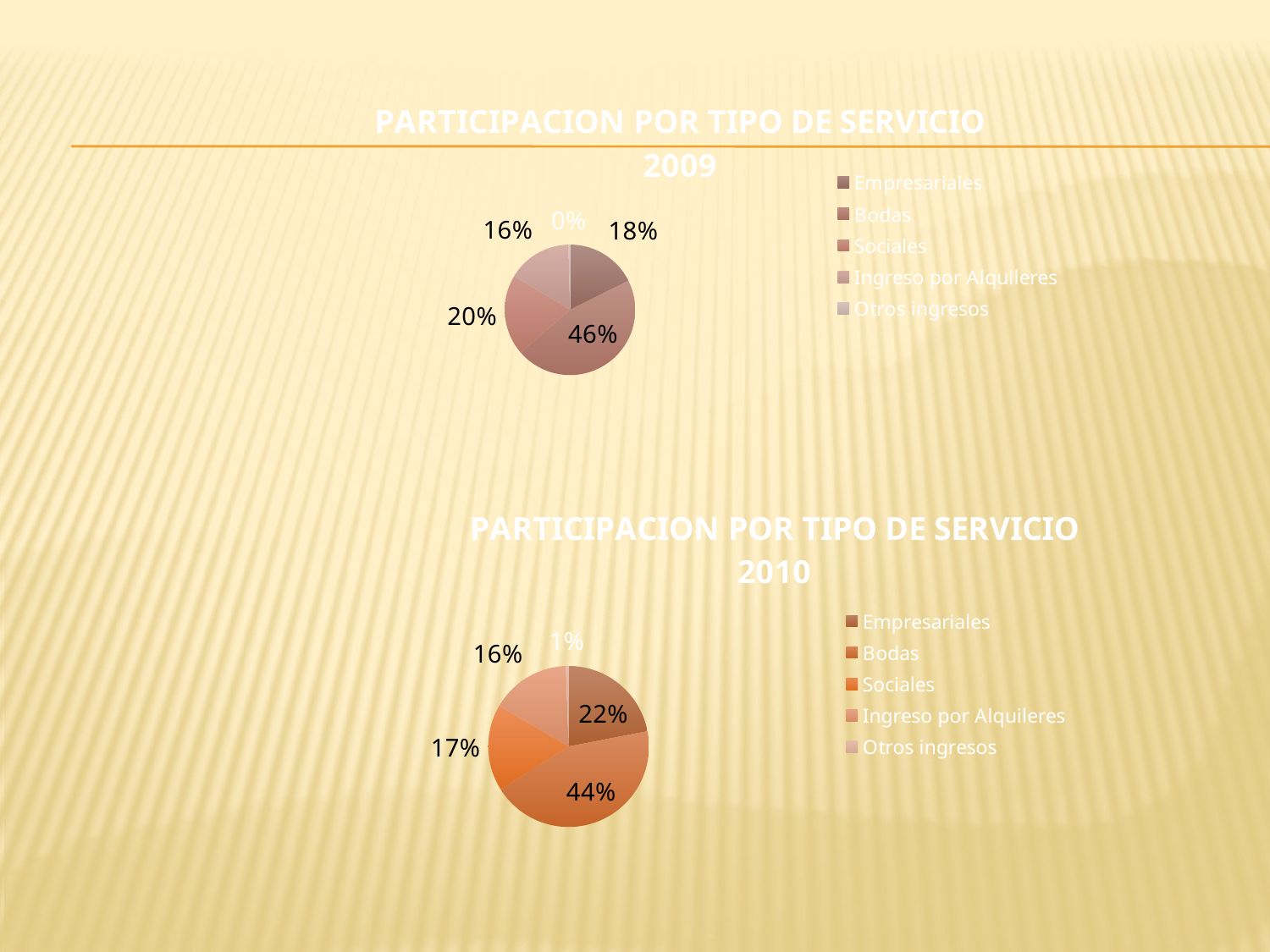
In the 'PARTICIPACION POR TIPO DE SERVICIO 2009' chart, which is larger, Sociales or Ingreso por Alquileres? Sociales How many categories does the legend of the 'PARTICIPACION POR TIPO DE SERVICIO 2009' chart list? 5 In the 'PARTICIPACION POR TIPO DE SERVICIO 2009' chart, what share does Sociales have? 20% What type of chart is the 'PARTICIPACION POR TIPO DE SERVICIO 2010' chart? Pie chart In the 'PARTICIPACION POR TIPO DE SERVICIO 2010' chart, what share does Bodas have? 44% In the 'PARTICIPACION POR TIPO DE SERVICIO 2009' chart, what share does Empresariales have? 18% In the 'PARTICIPACION POR TIPO DE SERVICIO 2010' chart, which category has the smallest share? Otros ingresos In the 'PARTICIPACION POR TIPO DE SERVICIO 2009' chart, what share does Bodas have? 46% In the 'PARTICIPACION POR TIPO DE SERVICIO 2010' chart, what share does Empresariales have? 22% In the 'PARTICIPACION POR TIPO DE SERVICIO 2010' chart, what is the difference between the Bodas share and the Empresariales share? 22% In the 'PARTICIPACION POR TIPO DE SERVICIO 2010' chart, what share does Otros ingresos have? 1% In the 'PARTICIPACION POR TIPO DE SERVICIO 2009' chart, which category has the largest share? Bodas